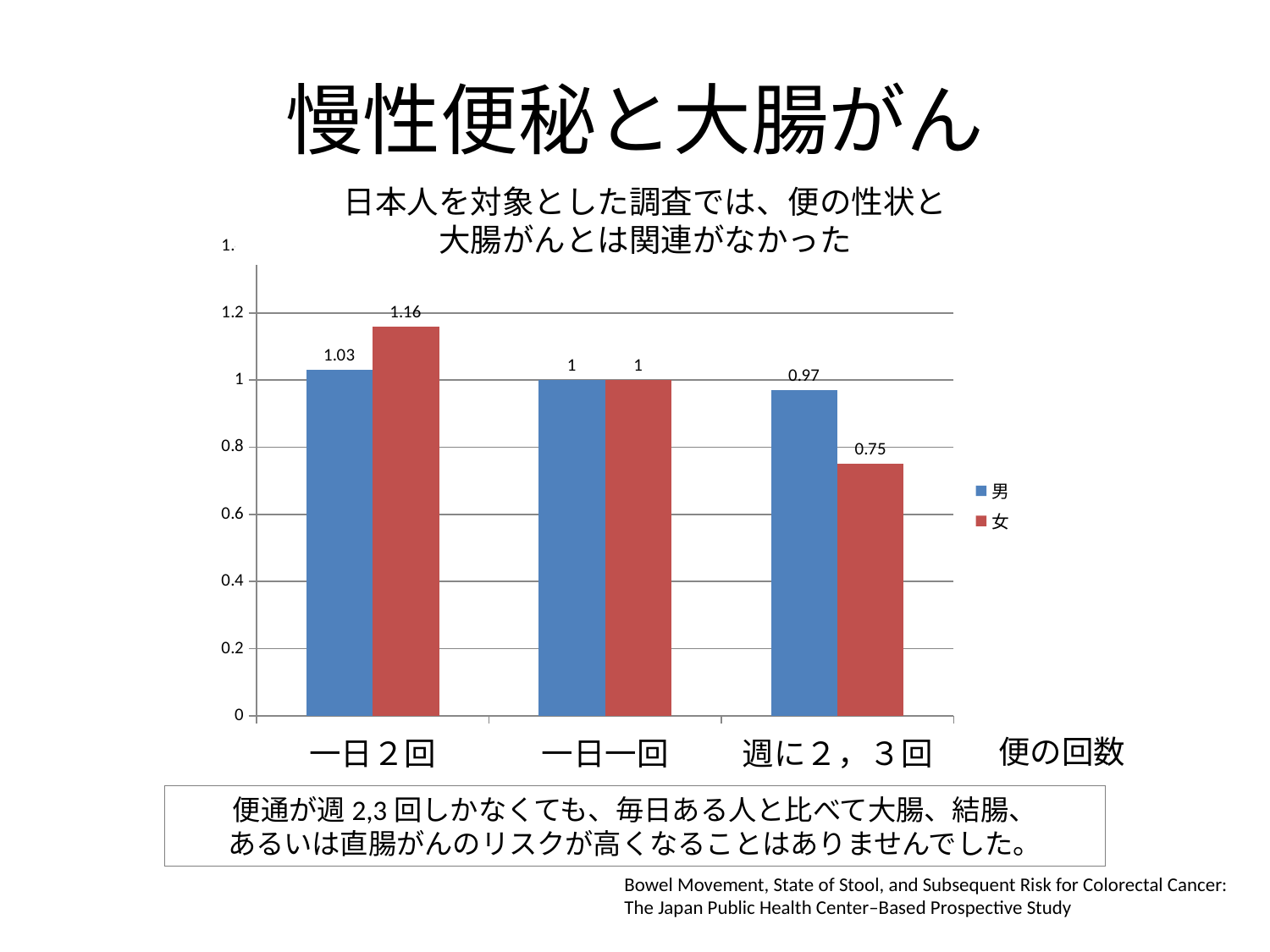
What kind of chart is shown on the slide? bar chart How many series does the legend list? 2 What is the value for 男 in the 一日２回 category? 1.03 In the 週に２，３回 category, which series has the larger value, 男 or 女? 男 What is the value for 男 in the 週に２，３回 category? 0.97 What is the difference between the 女 values for 一日２回 and 週に２，３回? 0.41 What is the value for 女 in the 週に２，３回 category? 0.75 Which category has the lowest value for 女? 週に２，３回 What is the value for 女 in the 一日２回 category? 1.16 How many categories are shown on the x axis? 3 Which category has the highest value for 女? 一日２回 What is the x-axis label of the chart? 便の回数